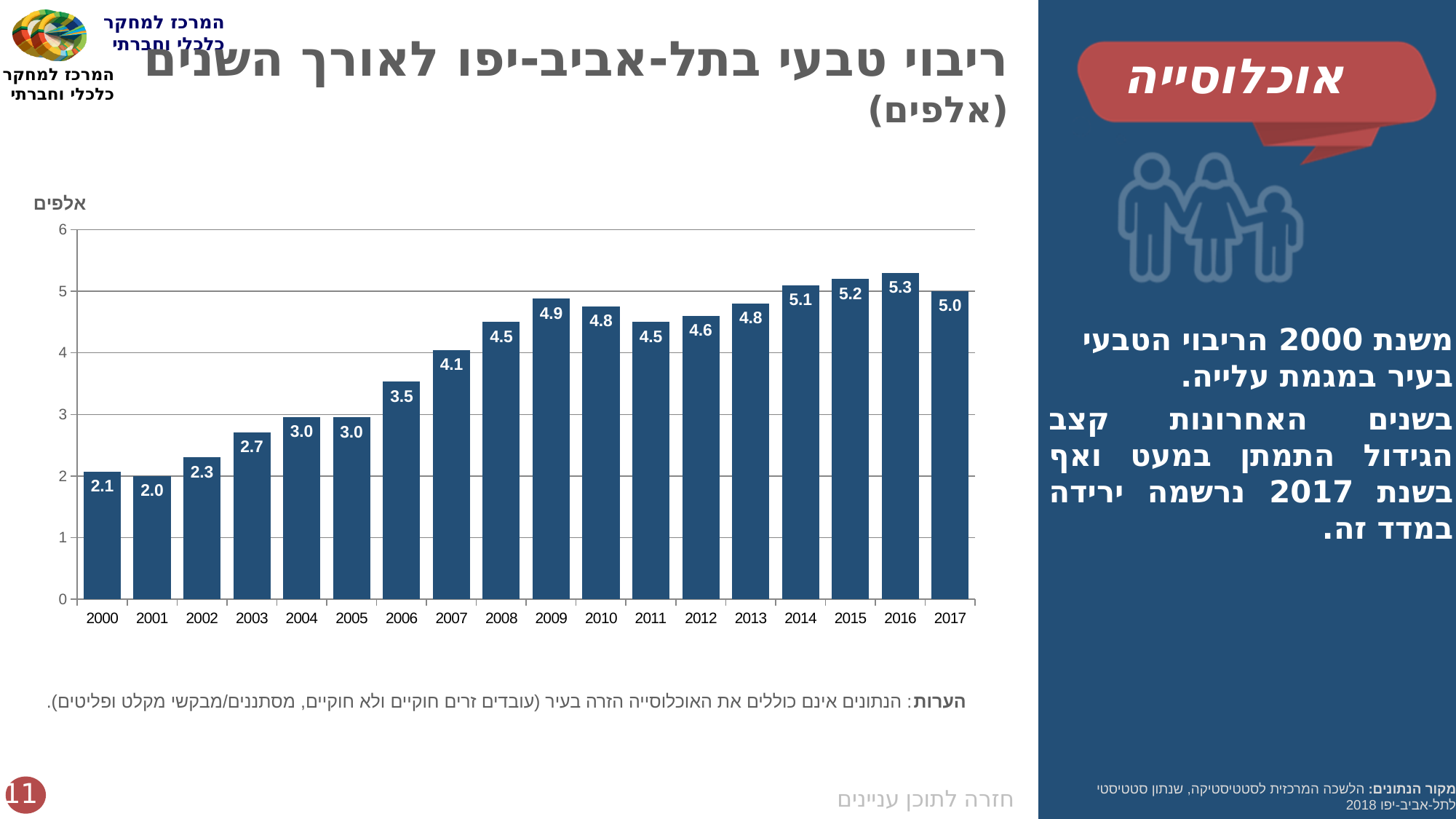
Which year has the highest value? 2016 What kind of chart is shown on the slide? bar chart What is the difference between the values for 2016 and 2000? 3.2 What is the value for 2017? 5.0 What is the difference between the values for 2017 and 2016? 0.3 Do the values generally rise or fall from 2000 to 2016? rise Is the value for 2007 greater or less than 4? greater What is the value for 2009? 4.9 How many years are shown on the x axis? 18 Which year has the lowest value? 2001 Which is larger, the value for 2010 or the value for 2011? 2010 What is the value for 2003? 2.7